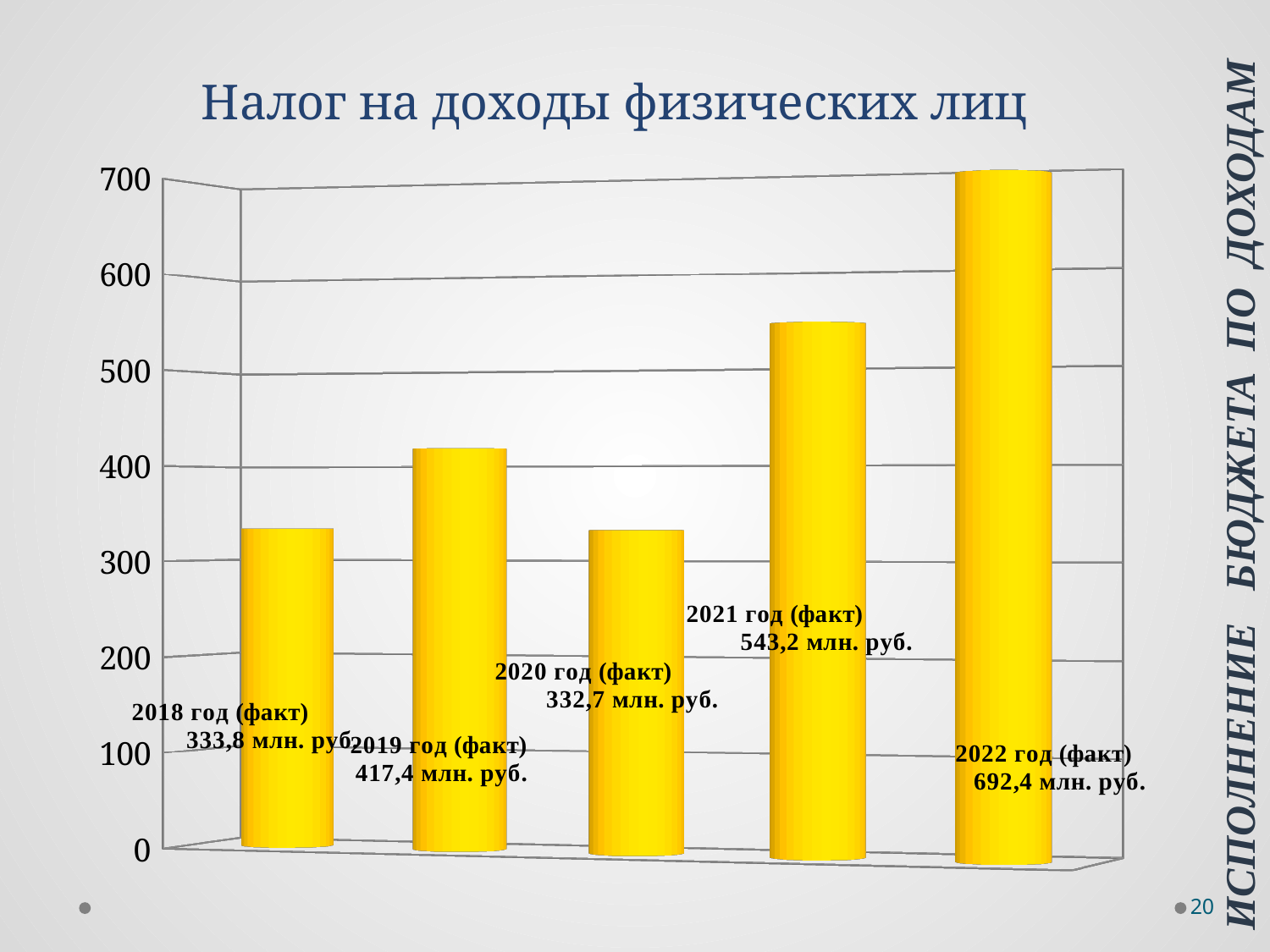
What is the value for 2018 год (факт)? 333,8 млн. руб. What is the value for 2021 год (факт)? 543,2 млн. руб. What is the title of the chart? Налог на доходы физических лиц Which is larger, the value for 2021 год (факт) or 2019 год (факт)? 2021 год (факт) Which year has the highest value? 2022 год (факт) What is the difference between the values for 2019 год (факт) and 2018 год (факт)? 83,6 млн. руб. What is the value for 2019 год (факт)? 417,4 млн. руб. Is the value for 2021 год (факт) greater or less than 500? greater How many bars are shown in the chart? 5 What kind of chart is shown on the slide? bar chart What is the value for 2022 год (факт)? 692,4 млн. руб. What is the difference between the values for 2022 год (факт) and 2021 год (факт)? 149,2 млн. руб.